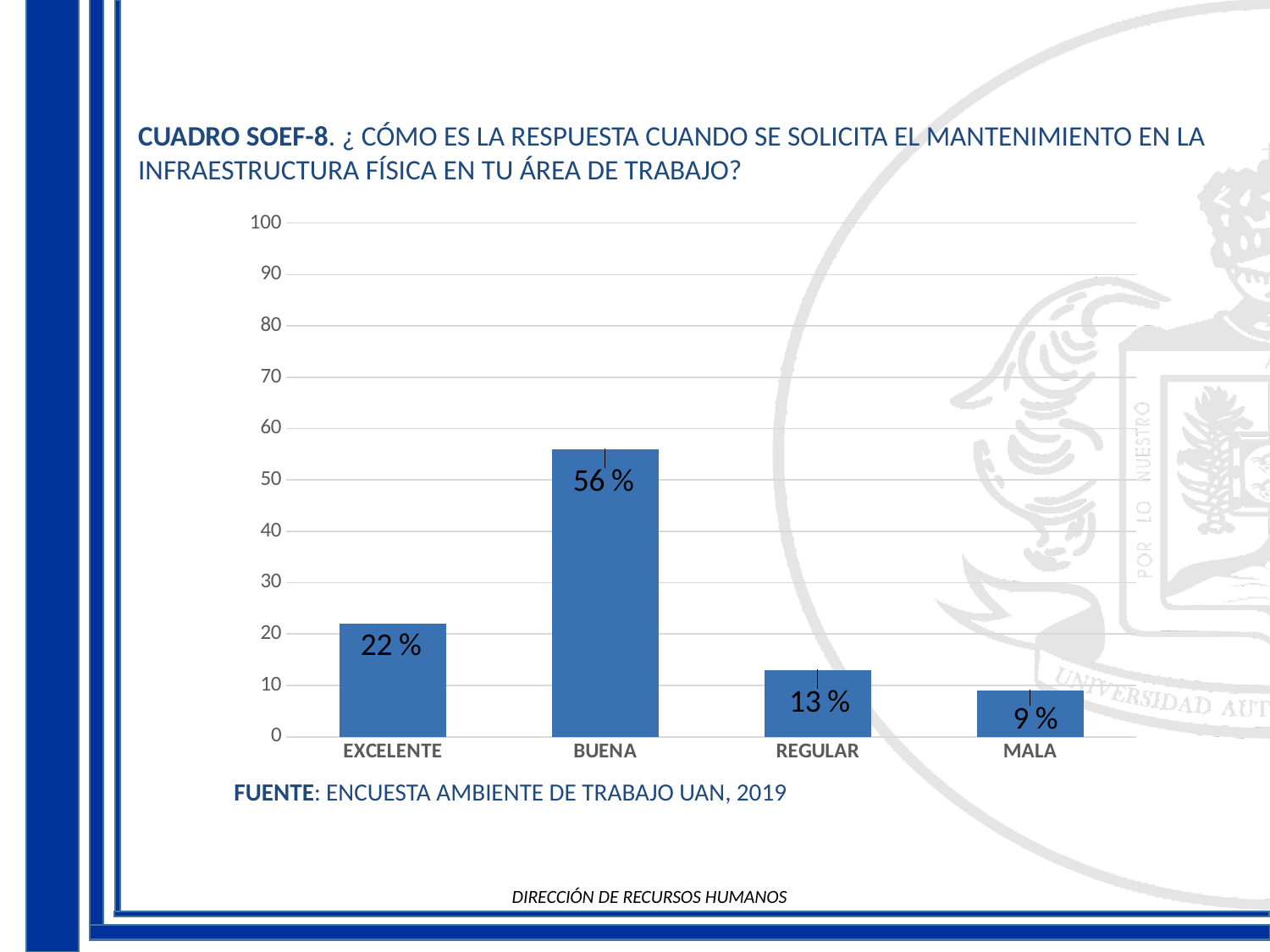
What is the value for EXCELENTE? 22 % What is the value for BUENA? 56 % Which category has the lowest value? MALA How many categories are shown on the x axis? 4 Which is larger, the value for EXCELENTE or the value for REGULAR? EXCELENTE What is the difference between the values for BUENA and EXCELENTE? 34 % What is the difference between the values for REGULAR and MALA? 4 % Which category has the highest value? BUENA What kind of chart is shown on the slide? bar chart Is the value for BUENA greater or less than 50? greater What is the value for MALA? 9 % What is the value for REGULAR? 13 %